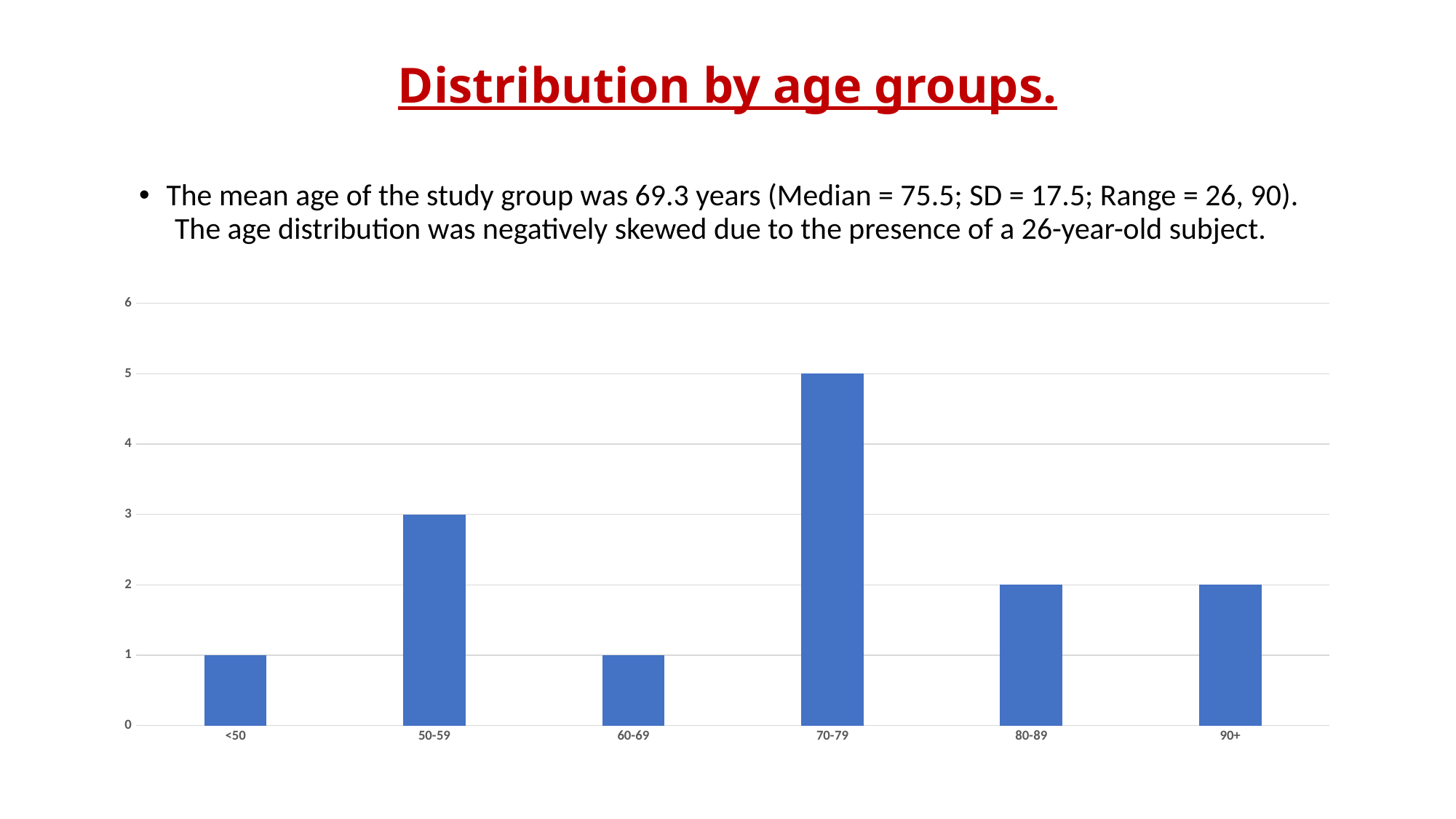
What is the title of the slide containing the chart? Distribution by age groups. Is the value for the 70-79 age group greater or less than 4? greater How many age group categories are shown on the x axis? 6 What is the difference between the values for the 70-79 and 50-59 age groups? 2 What kind of chart is shown on the slide? bar chart Which is larger, the value for 50-59 or the value for 80-89? 50-59 What is the difference between the values for the 80-89 and 60-69 age groups? 1 What is the value for the 90+ age group? 2 Which age group has the highest value? 70-79 What is the value for the 50-59 age group? 3 What is the value for the 70-79 age group? 5 What is the value for the <50 age group? 1